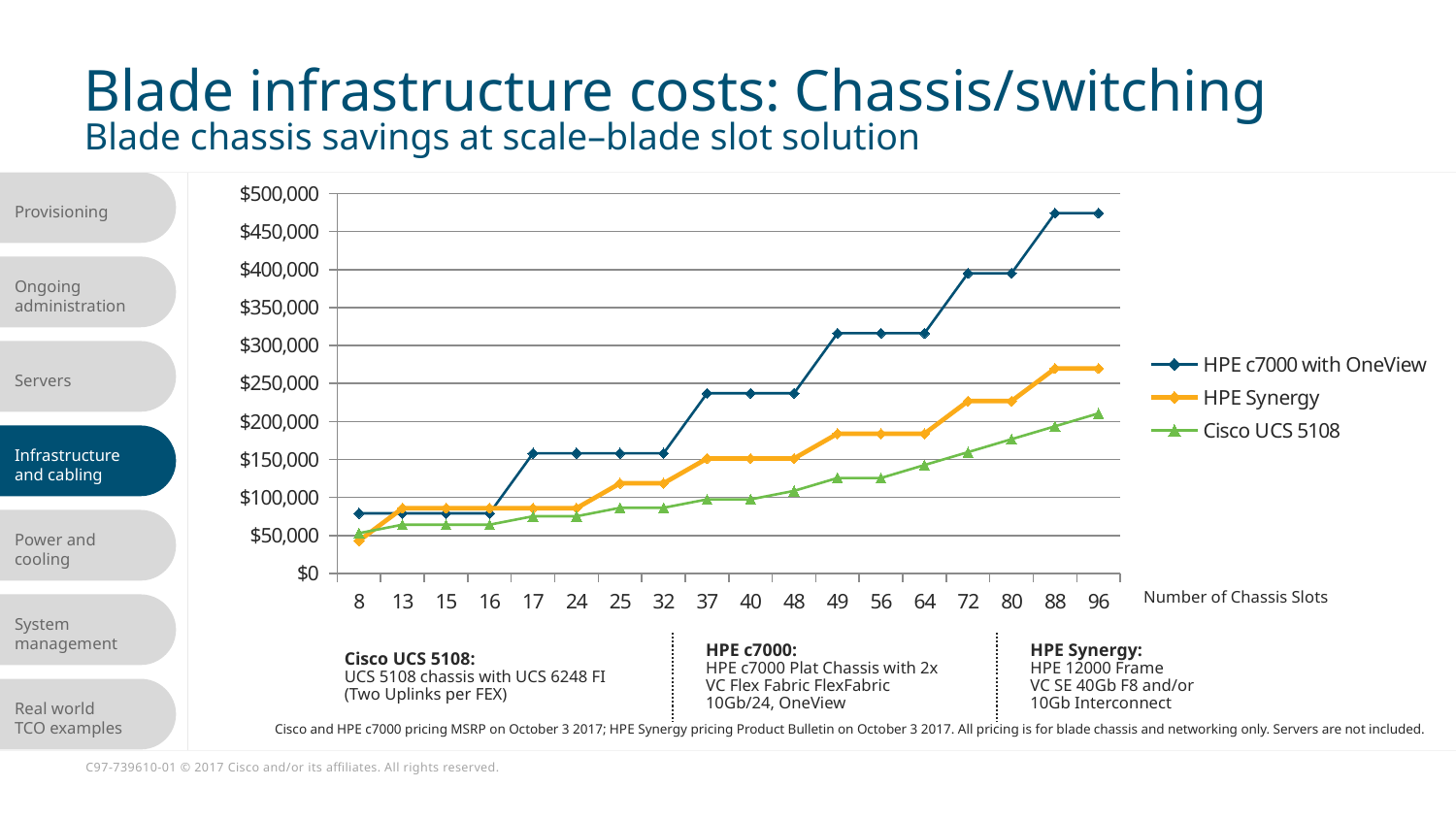
Do the values for Cisco UCS 5108 generally rise or fall as the number of chassis slots increases? Rise Is the value for HPE Synergy at 96 chassis slots greater or less than $250,000? greater What kind of chart is shown on the slide? Line chart What is the label of the x axis? Number of Chassis Slots Which series has the lowest value at 96 chassis slots? Cisco UCS 5108 How many series does the legend list? 3 Is the value for Cisco UCS 5108 at 96 chassis slots greater or less than $250,000? less How many chassis-slot values are plotted along the x axis? 18 Which series has the highest value at 96 chassis slots? HPE c7000 with OneView Is the value for HPE c7000 with OneView at 8 chassis slots greater or less than $100,000? less At 96 chassis slots, which is larger: HPE Synergy or Cisco UCS 5108? HPE Synergy